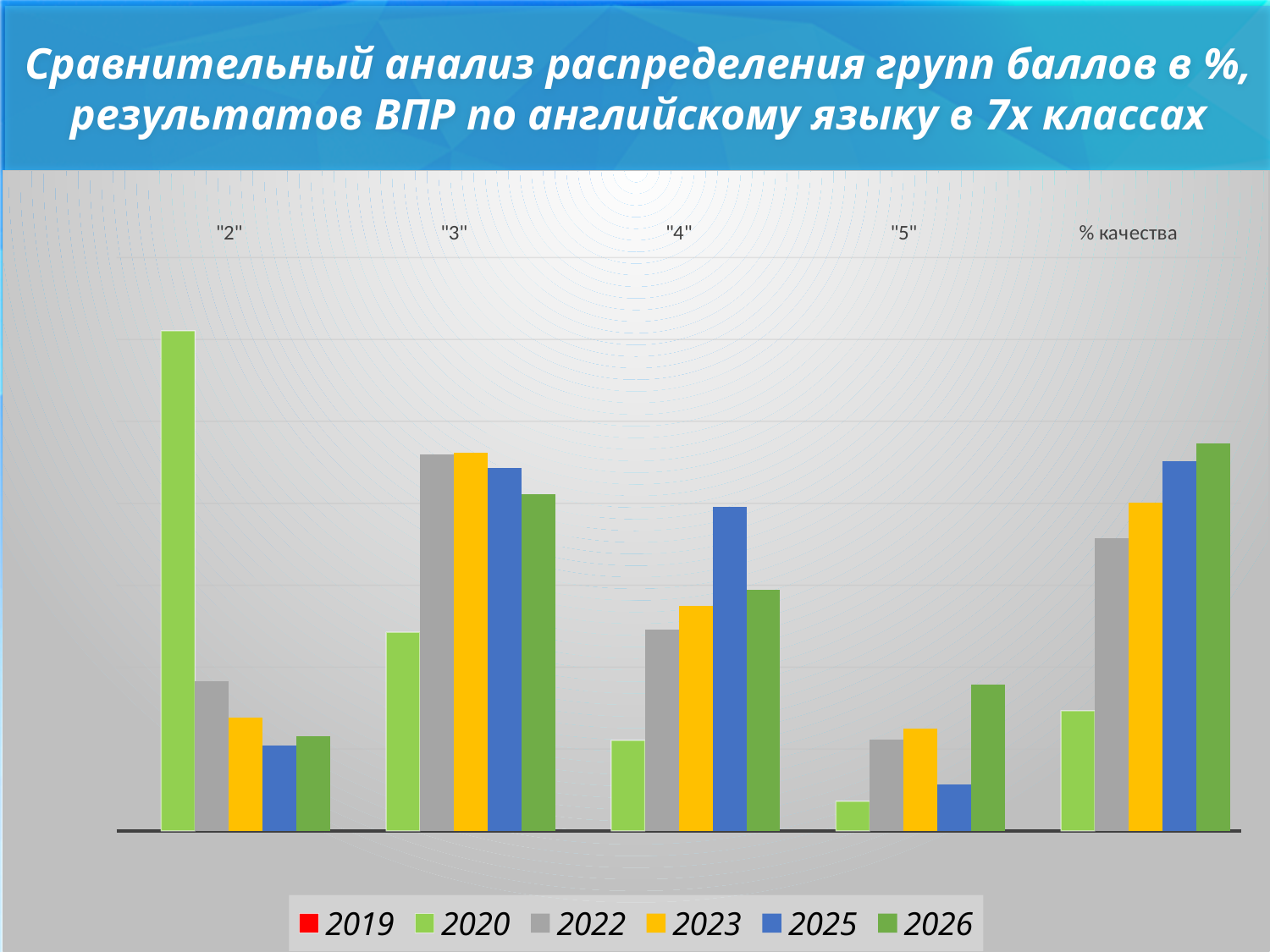
In the "2" category, which year has the highest bar? 2020 In the "4" category, which year has the highest bar? 2025 Which year listed in the legend has no visible bars in the chart? 2019 In the "4" category, which is larger: the bar for 2025 or the bar for 2026? 2025 In the "5" category, which year has the lowest bar? 2020 How many series does the legend list? 6 How many categories are shown along the x axis of the chart? 5 In the "3" category, which year has the lowest bar? 2020 In the "% качества" category, do the bars rise or fall from 2020 through 2026? rise What kind of chart is shown on the slide? bar chart In the "5" category, which year has the highest bar? 2026 In the "% качества" category, which year has the lowest bar? 2020